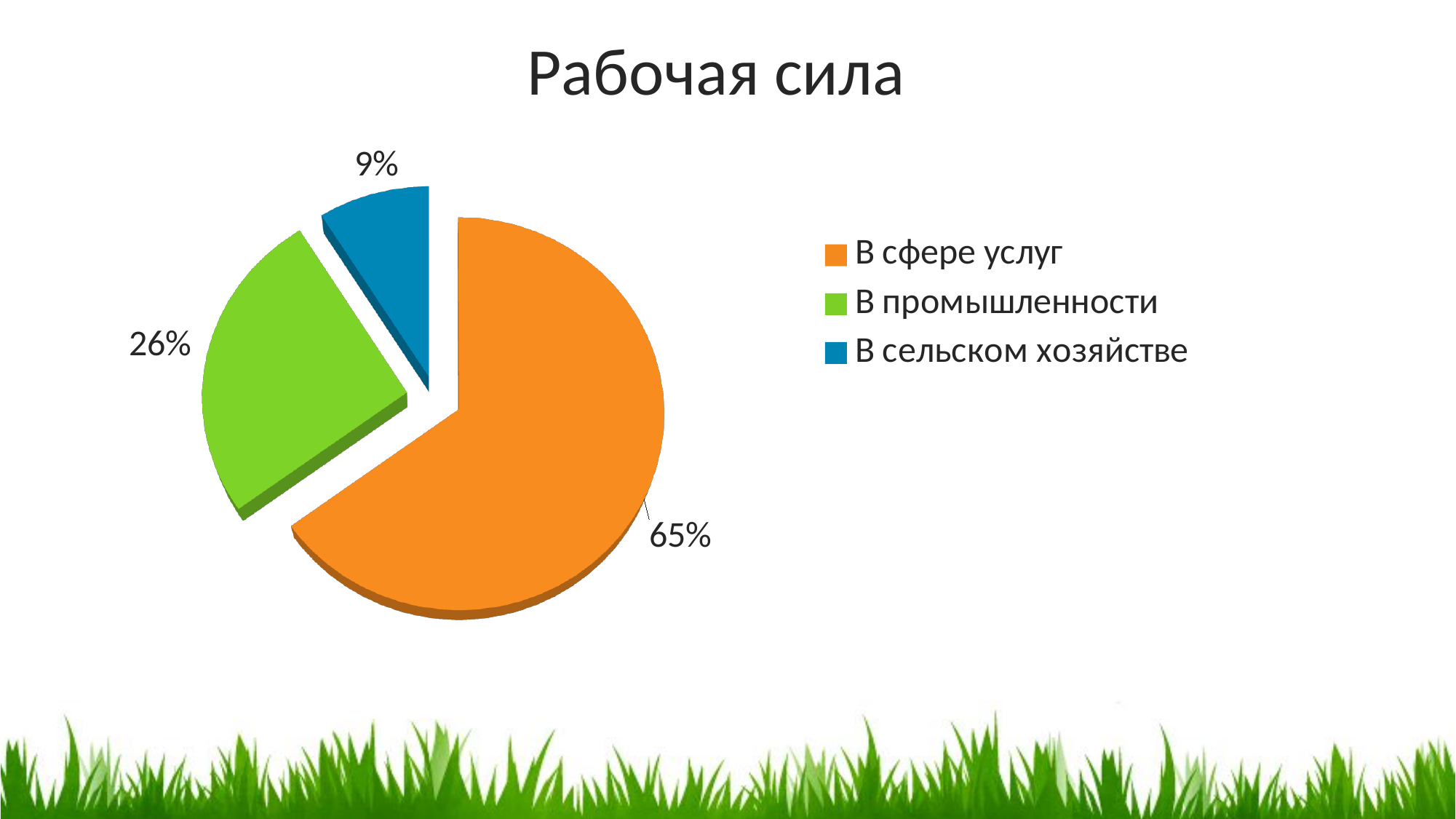
Which is larger, the slice for "В промышленности" or the slice for "В сельском хозяйстве"? В промышленности How many entries does the legend list? 3 Which category has the largest slice of the pie? В сфере услуг What share of the pie is labelled for "В промышленности"? 26% What colour is the slice for "В сельском хозяйстве"? Blue What kind of chart is shown on the slide? Pie chart What share of the pie is labelled for "В сфере услуг"? 65% Which category has the smallest slice of the pie? В сельском хозяйстве What is the difference in percentage points between "В сфере услуг" and "В промышленности"? 39 How many slices does the pie chart have? 3 What is the title of the chart? Рабочая сила What share of the pie is labelled for "В сельском хозяйстве"? 9%